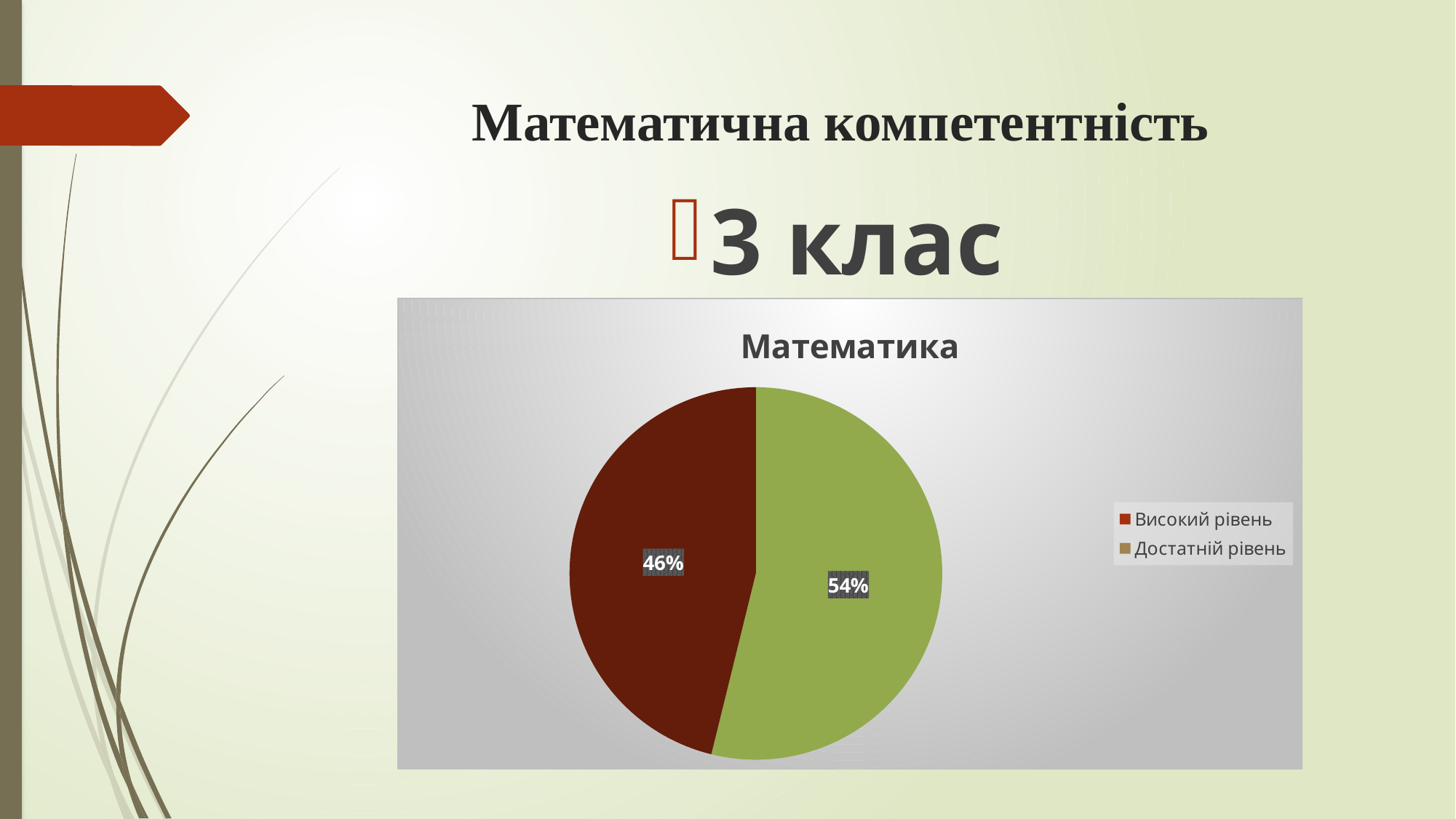
Is the value for "Високий рівень" greater or less than 50%? less How many slices does the pie chart have? 2 What type of chart is shown on the slide? pie chart How many entries does the legend list? 2 What is the title of the chart? Математика Which slice is the smallest in the pie chart? Високий рівень Which is larger: "Високий рівень" or "Достатній рівень"? Достатній рівень What is the difference in percentage points between "Достатній рівень" and "Високий рівень"? 8 What share of the pie does "Високий рівень" have? 46% Which colour represents "Високий рівень" in the pie chart? dark red Which slice is the largest in the pie chart? Достатній рівень What share of the pie does "Достатній рівень" have? 54%